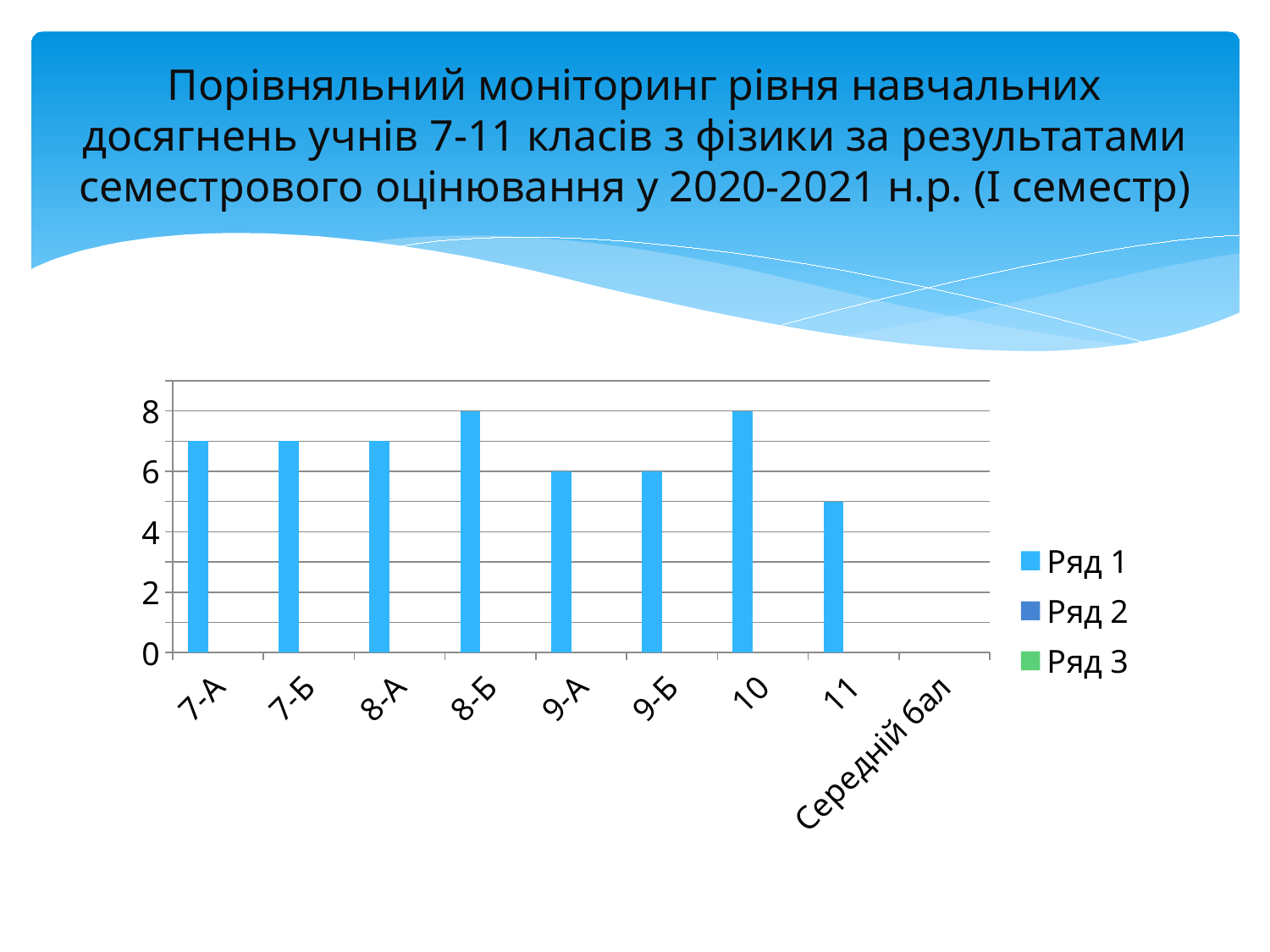
Is the value for 11 greater or less than 6? less What is the difference between the values for 8-Б and 9-А? 2 How many categories are shown on the x axis? 9 Is the value for 7-А greater or less than 6? greater What is the value for 9-А? 6 What type of chart is shown on the slide? bar chart What is the value for 8-Б? 8 What is the value for 10? 8 How many series does the legend list? 3 Which is larger, the value for 7-Б or the value for 9-Б? 7-Б What is the value for 9-Б? 6 Which is larger, the value for 8-Б or the value for 11? 8-Б